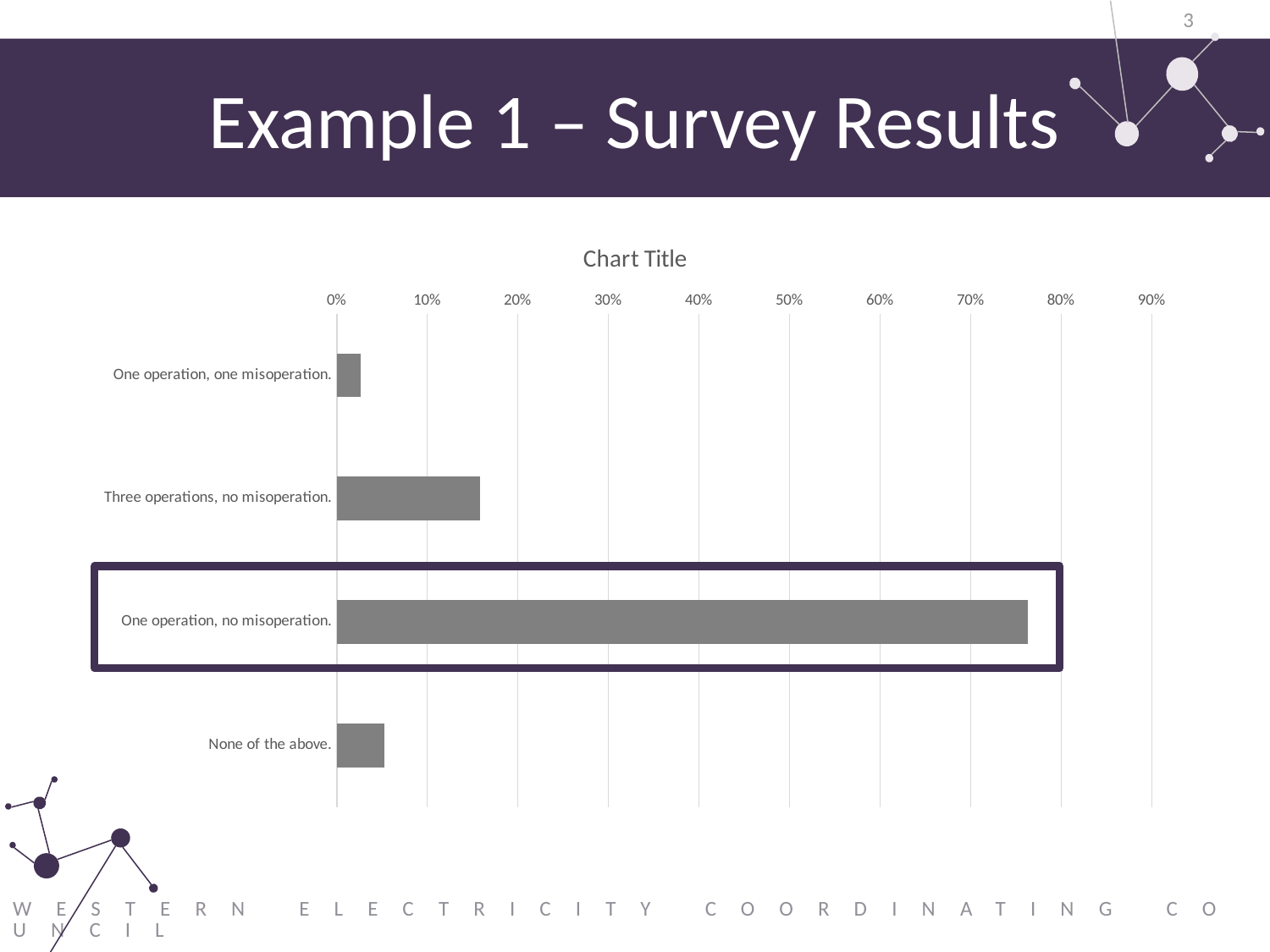
Which category has the highest value in the chart? One operation, no misoperation. Is the value for "Three operations, no misoperation." greater or less than 10%? greater Is the value for "One operation, no misoperation." greater or less than 80%? less Is the value for "One operation, no misoperation." greater or less than 70%? greater What kind of chart is shown on the slide? bar chart What is the title shown above the chart? Chart Title Which is larger: the value for "Three operations, no misoperation." or the value for "None of the above."? Three operations, no misoperation. How many categories are plotted in the chart? 4 Which category's bar is outlined with a dark rectangle on the slide? One operation, no misoperation.